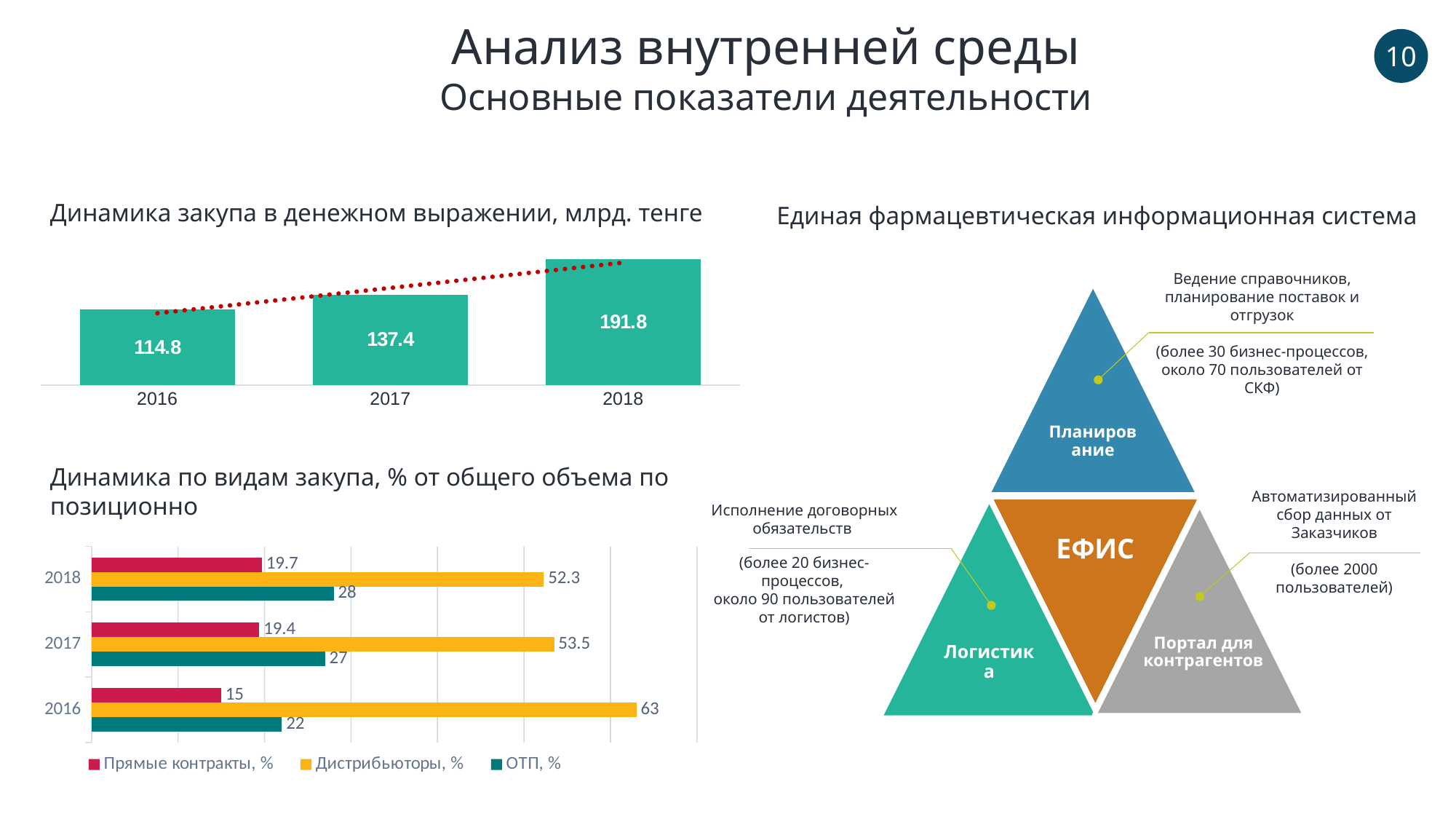
In the chart 'Динамика закупа в денежном выражении, млрд. тенге', which year has the highest value? 2018 In the chart 'Динамика по видам закупа, % от общего объема по позиционно', what is the value for Дистрибьюторы, % in 2016? 63 What kind of chart is 'Динамика по видам закупа, % от общего объема по позиционно'? bar chart In the chart 'Динамика по видам закупа, % от общего объема по позиционно', what is the difference between Дистрибьюторы, % in 2016 and in 2018? 10.7 In the chart 'Динамика по видам закупа, % от общего объема по позиционно', how many series does the legend list? 3 In the chart 'Динамика закупа в денежном выражении, млрд. тенге', do the values rise or fall from 2016 to 2018? rise In the chart 'Динамика закупа в денежном выражении, млрд. тенге', what is the difference between the 2018 and 2016 values? 77 In the chart 'Динамика по видам закупа, % от общего объема по позиционно', which is larger in 2017: Дистрибьюторы, % or ОТП, %? Дистрибьюторы, % In the chart 'Динамика закупа в денежном выражении, млрд. тенге', how many years are shown? 3 In the chart 'Динамика закупа в денежном выражении, млрд. тенге', what is the value for 2017? 137.4 In the chart 'Динамика по видам закупа, % от общего объема по позиционно', which year has the lowest value for Прямые контракты, %? 2016 In the chart 'Динамика по видам закупа, % от общего объема по позиционно', what is the value for ОТП, % in 2018? 28